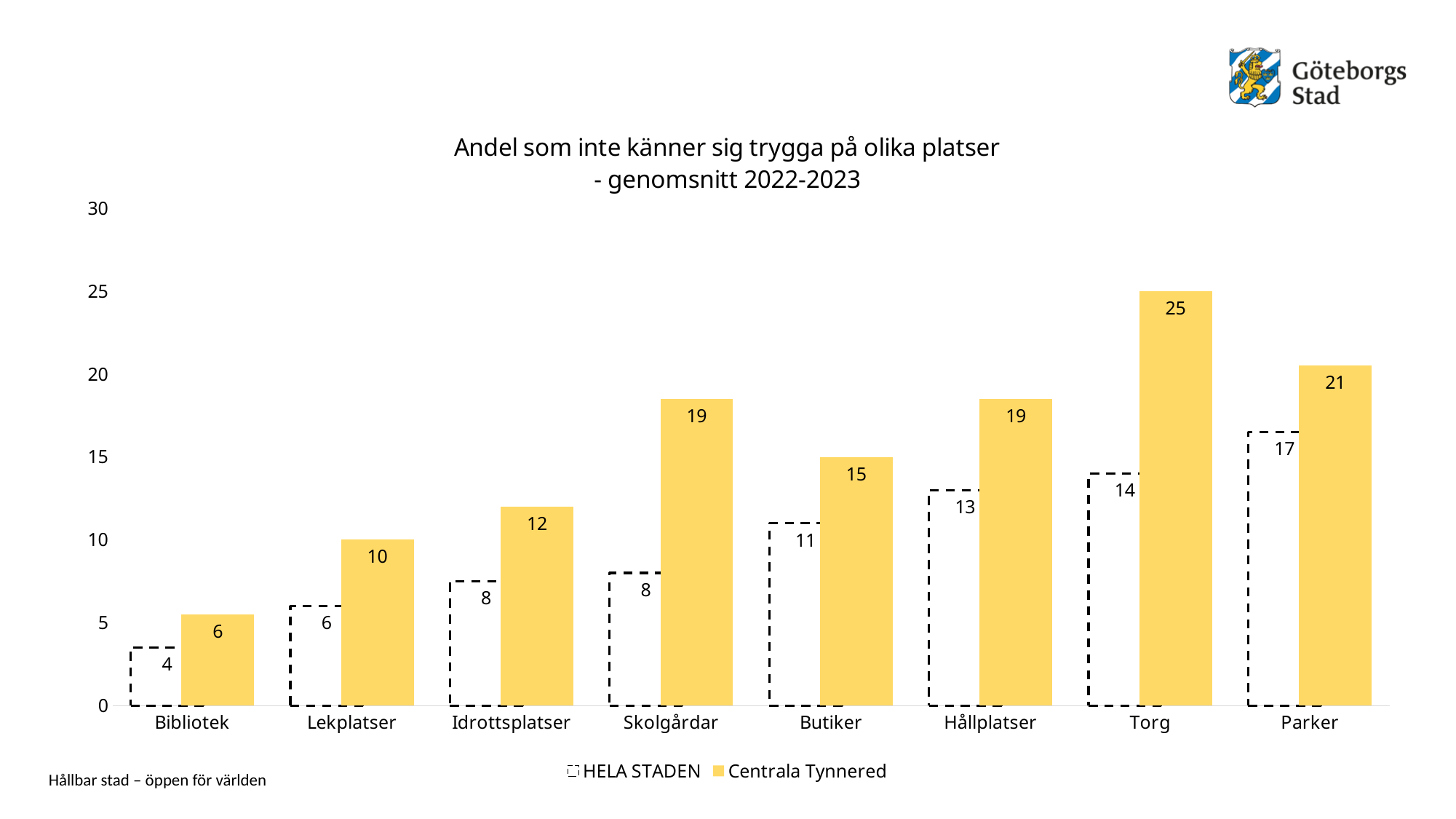
How many series does the legend list? 2 What kind of chart is shown on the slide? Bar chart Which category has the lowest value for HELA STADEN? Bibliotek How many categories are shown on the x axis? 8 Which category has the highest value for Centrala Tynnered? Torg What is the value for Centrala Tynnered at Torg? 25 What is the value for HELA STADEN at Parker? 17 What is the value for HELA STADEN at Bibliotek? 4 What is the difference between Centrala Tynnered and HELA STADEN at Skolgårdar? 11 Which is larger at Parker: the value for HELA STADEN or for Centrala Tynnered? Centrala Tynnered What is the value for Centrala Tynnered at Butiker? 15 Which series is drawn with a dashed outline? HELA STADEN